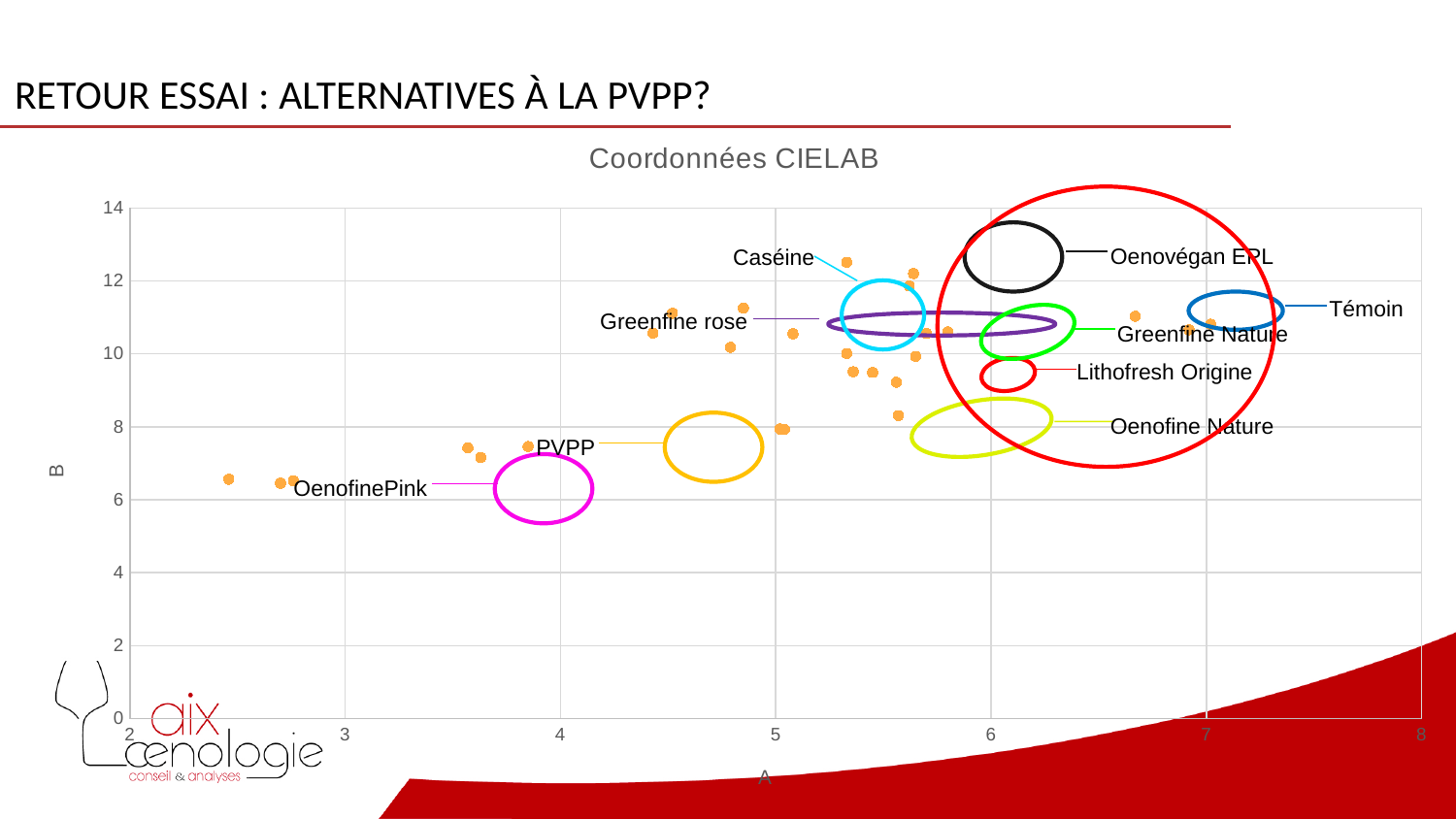
Which has a higher B value, the Témoin group or the OenofinePink group? Témoin Is the B value for the Caséine points greater or less than 10? greater Is the B value for the OenofinePink points greater or less than 8? less Is the A value for the Témoin points greater or less than 6? greater What is the title of the chart? Coordonnées CIELAB How many labeled treatment groups are annotated on the chart? 9 What kind of chart is shown on the slide? scatter chart What label is on the vertical axis of the chart? B Which labeled group is positioned lowest on the B axis? OenofinePink